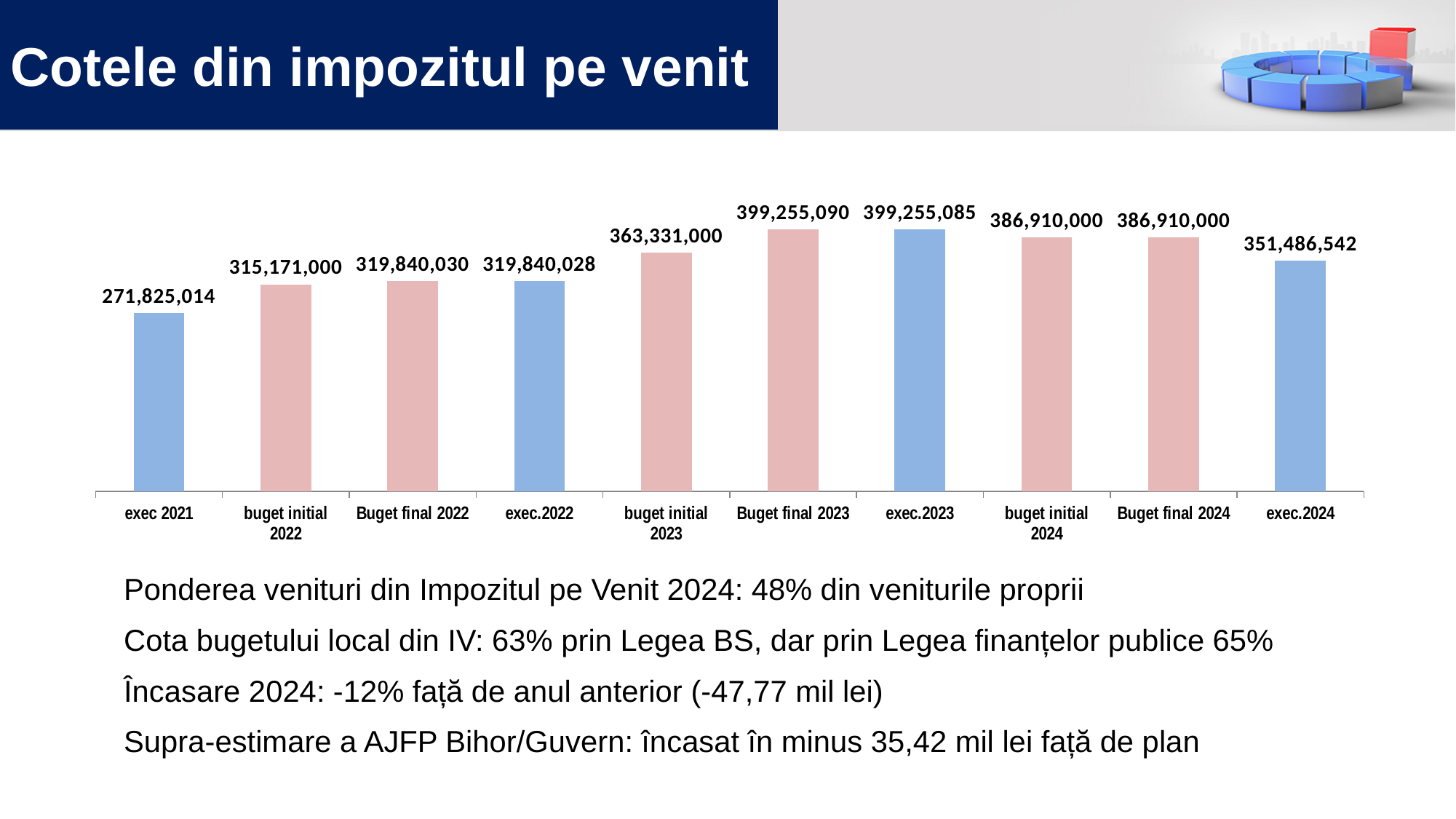
What is the value for Buget final 2024? 386,910,000 What is the difference between Buget final 2024 and exec.2024? 35,423,458 What is the value for buget initial 2023? 363,331,000 What is the value for exec.2024? 351,486,542 What kind of chart is shown on the slide? bar chart What is the difference between exec.2023 and exec.2024? 47,768,543 What is the value for exec 2021? 271,825,014 How many bars are shown in the chart? 10 Which is larger, exec.2023 or exec.2024? exec.2023 Which is larger, buget initial 2022 or buget initial 2023? buget initial 2023 What is the value for exec.2022? 319,840,028 Which category has the lowest value? exec 2021